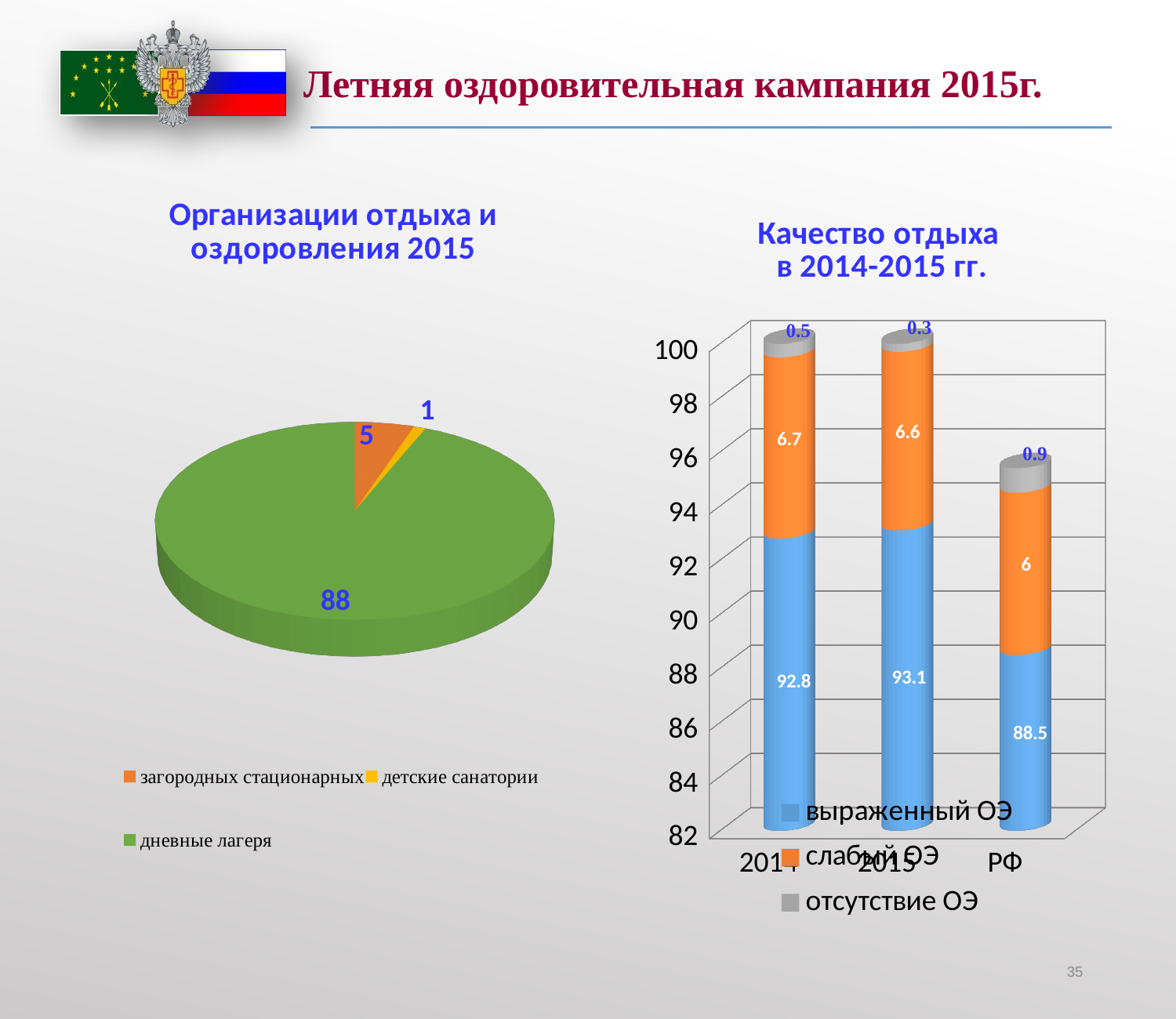
In the bar chart 'Качество отдыха в 2014-2015 гг.', what is the value of отсутствие ОЭ for 2014? 0.5 How many series does the legend of the bar chart 'Качество отдыха в 2014-2015 гг.' list? 3 In the bar chart 'Качество отдыха в 2014-2015 гг.', what is the value of слабый ОЭ for РФ? 6 In the bar chart 'Качество отдыха в 2014-2015 гг.', which category has the lowest value of выраженный ОЭ? РФ In the pie chart 'Организации отдыха и оздоровления 2015', how many slices are there? 3 In the bar chart 'Качество отдыха в 2014-2015 гг.', what is the total of the stacked bar for РФ? 95.4 What kind of chart is the left chart, 'Организации отдыха и оздоровления 2015'? pie chart In the bar chart 'Качество отдыха в 2014-2015 гг.', what is the value of выраженный ОЭ for 2015? 93.1 In the pie chart 'Организации отдыха и оздоровления 2015', which category has the smallest slice? детские санатории In the pie chart 'Организации отдыха и оздоровления 2015', what is the value for дневные лагеря? 88 In the pie chart 'Организации отдыха и оздоровления 2015', what is the value for загородных стационарных? 5 In the bar chart 'Качество отдыха в 2014-2015 гг.', what is the difference between выраженный ОЭ for 2015 and for 2014? 0.3